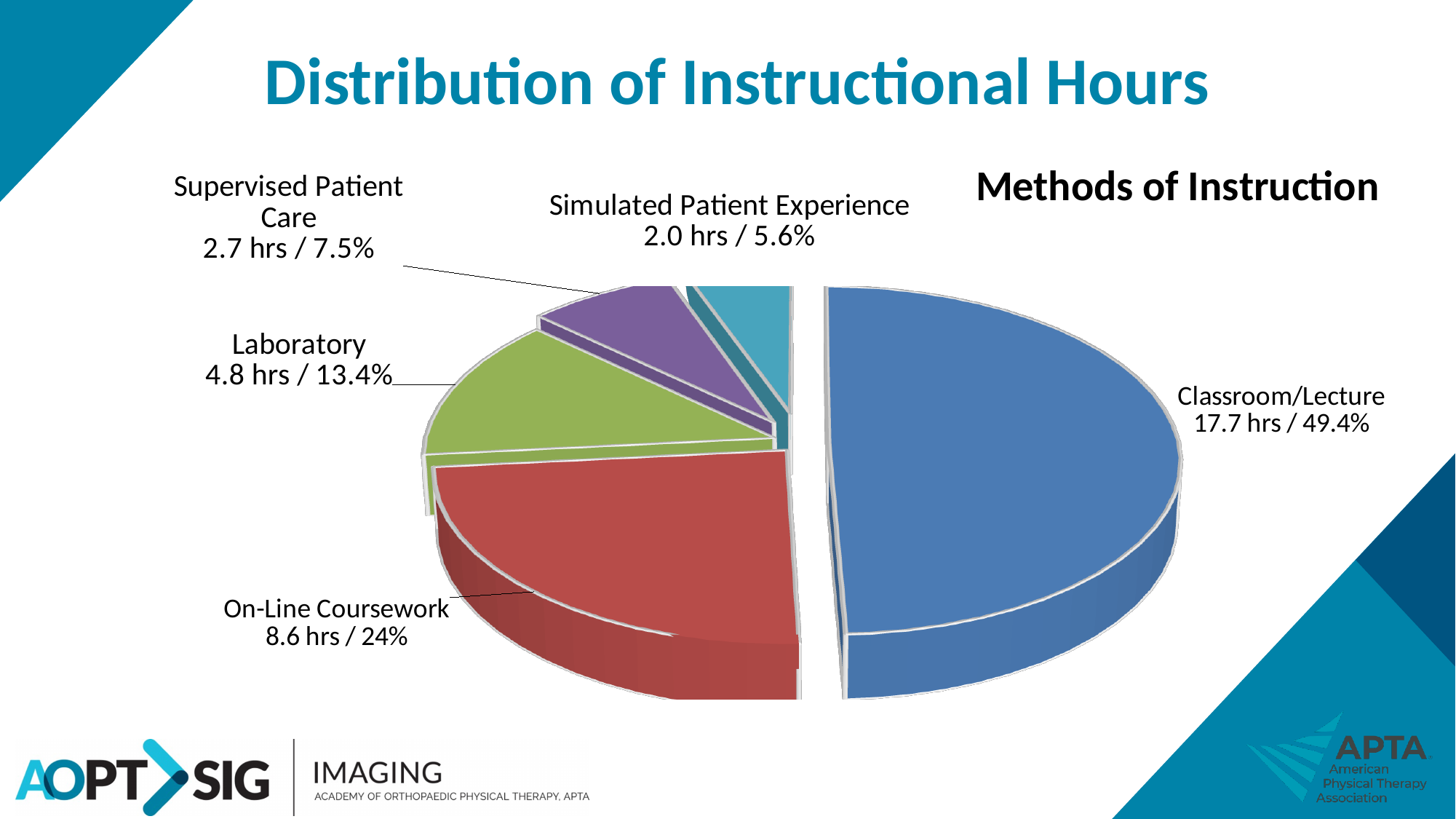
What percentage of instructional hours is Supervised Patient Care? 7.5% Which method of instruction has the smallest share of instructional hours? Simulated Patient Experience How many categories (slices) does the pie chart have? 5 How many hours are shown for Laboratory? 4.8 hrs Which method of instruction has the largest share of instructional hours? Classroom/Lecture What is the title of the pie chart? Methods of Instruction How many more hours does Classroom/Lecture have than On-Line Coursework? 9.1 hrs How many hours are shown for Simulated Patient Experience? 2.0 hrs How many hours are shown for Classroom/Lecture? 17.7 hrs What kind of chart is shown on the slide? Pie chart What percentage of instructional hours is On-Line Coursework? 24% Which has more instructional hours, Laboratory or Supervised Patient Care? Laboratory